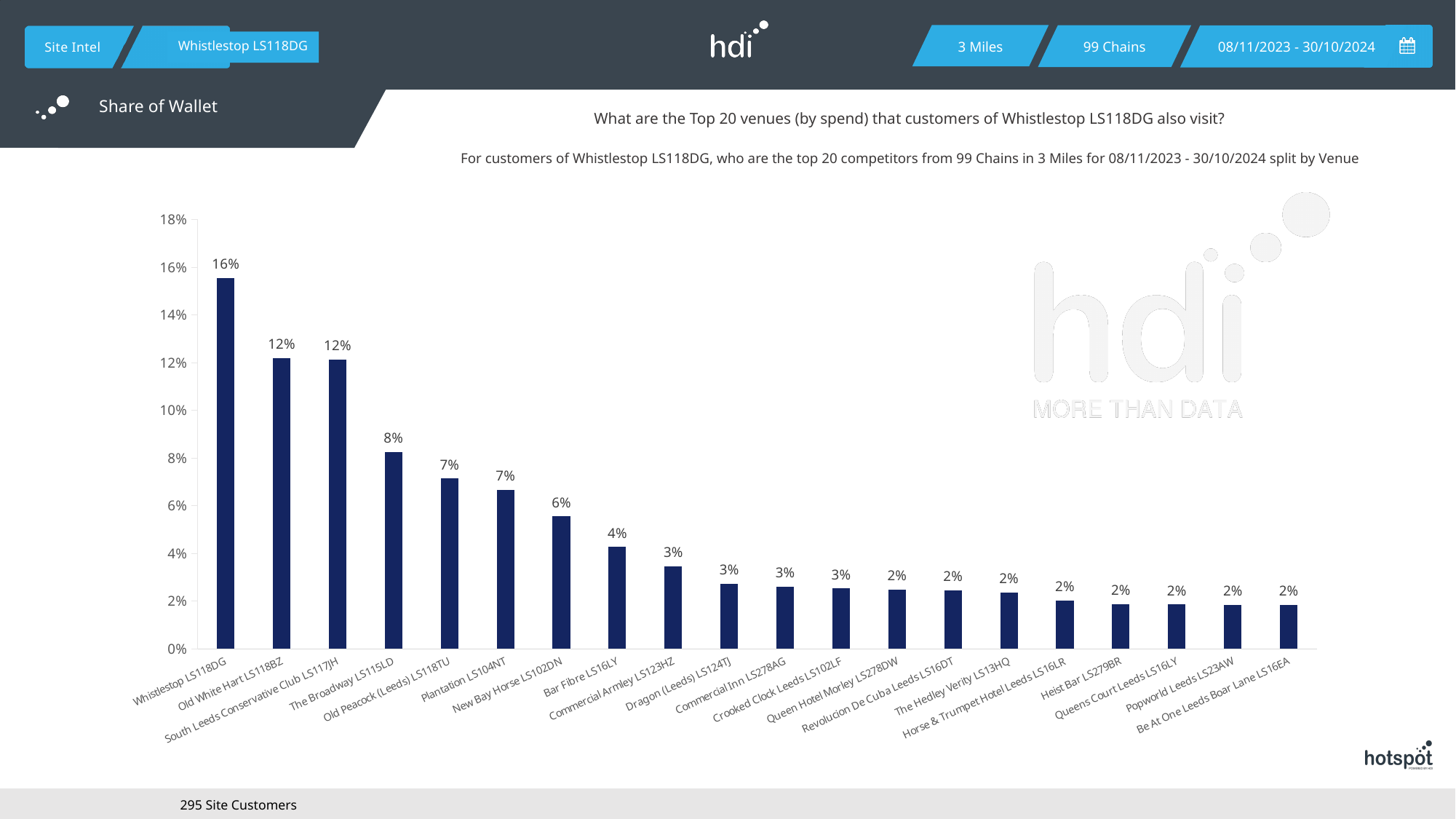
Is the value for Whistlestop LS118DG greater or less than 14%? greater What is the value for Whistlestop LS118DG? 16% Which is larger, the value for Old White Hart LS118BZ or the value for Plantation LS104NT? Old White Hart LS118BZ How many venues are shown on the chart? 20 What is the difference between the values for Whistlestop LS118DG and The Broadway LS115LD? 8 percentage points What is the question posed in the chart's title? What are the Top 20 venues (by spend) that customers of Whistlestop LS118DG also visit? Do the values rise or fall from left to right along the x axis? Fall What is the value for The Broadway LS115LD? 8% Which venue has the highest share of wallet? Whistlestop LS118DG What is the value for New Bay Horse LS102DN? 6% What is the value for Bar Fibre LS16LY? 4% What kind of chart is shown on the slide? Bar chart